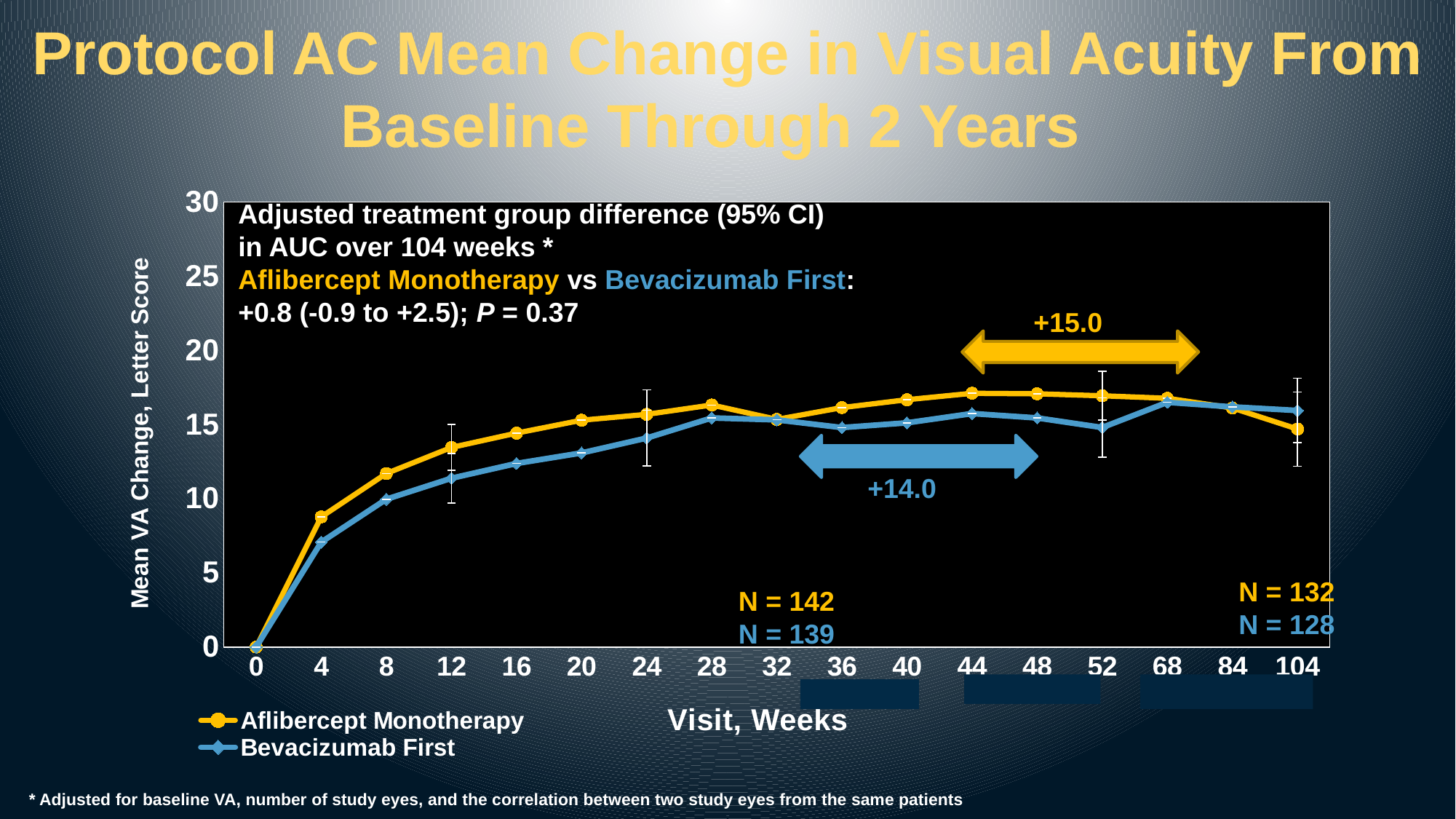
Is the value for Bevacizumab First at week 44 greater or less than 20? less What value is printed on the yellow arrow above the lines? +15.0 How many visit time points are marked on the x axis? 17 At week 12, which series has the higher mean VA change: Aflibercept Monotherapy or Bevacizumab First? Aflibercept Monotherapy Is the value for Aflibercept Monotherapy at week 4 greater or less than 5? greater How many series does the legend list? 2 Is the value for Aflibercept Monotherapy at week 104 greater or less than 10? greater At week 104, which series has the higher mean VA change: Aflibercept Monotherapy or Bevacizumab First? Bevacizumab First What is the y-axis label of the chart? Mean VA Change, Letter Score Does the Aflibercept Monotherapy line rise or fall between week 0 and week 44? rise What kind of chart is shown on the slide? line chart